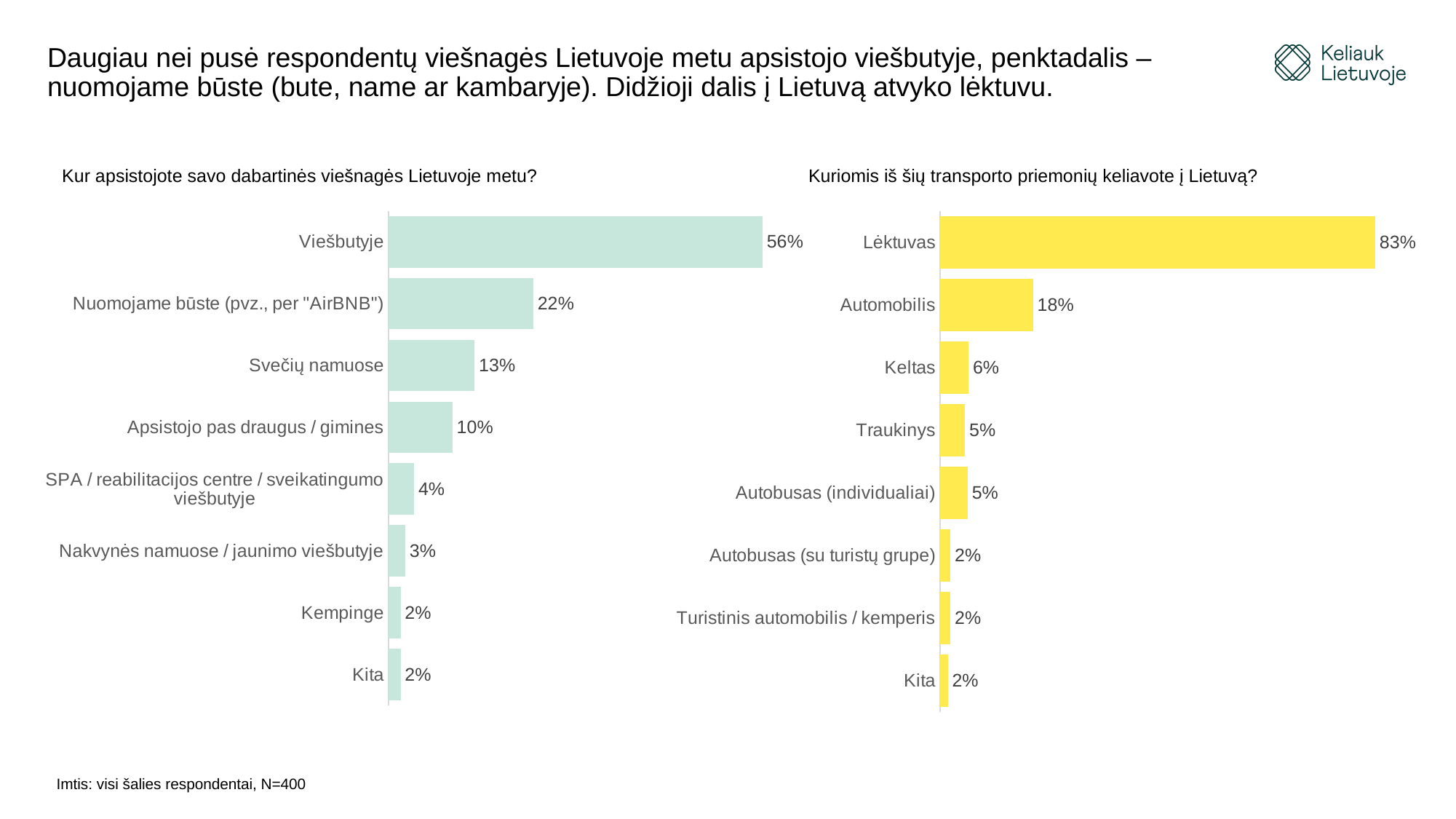
In the right chart (Kuriomis iš šių transporto priemonių keliavote į Lietuvą?), which category has the highest value? Lėktuvas How many categories does the left chart (Kur apsistojote savo dabartinės viešnagės Lietuvoje metu?) show? 8 What type of chart is the right chart (Kuriomis iš šių transporto priemonių keliavote į Lietuvą?)? Bar chart In the left chart (Kur apsistojote savo dabartinės viešnagės Lietuvoje metu?), which category has the highest value? Viešbutyje In the right chart (Kuriomis iš šių transporto priemonių keliavote į Lietuvą?), which is larger: Keltas or Traukinys? Keltas In the left chart (Kur apsistojote savo dabartinės viešnagės Lietuvoje metu?), what is the value for Svečių namuose? 13% In the left chart (Kur apsistojote savo dabartinės viešnagės Lietuvoje metu?), what is the value for Viešbutyje? 56% In the left chart (Kur apsistojote savo dabartinės viešnagės Lietuvoje metu?), which is larger: Apsistojo pas draugus / gimines or SPA / reabilitacijos centre / sveikatingumo viešbutyje? Apsistojo pas draugus / gimines In the right chart (Kuriomis iš šių transporto priemonių keliavote į Lietuvą?), what is the value for Automobilis? 18% In the right chart (Kuriomis iš šių transporto priemonių keliavote į Lietuvą?), what is the difference between Lėktuvas and Automobilis? 65% How many categories does the right chart (Kuriomis iš šių transporto priemonių keliavote į Lietuvą?) show? 8 In the left chart (Kur apsistojote savo dabartinės viešnagės Lietuvoje metu?), what is the difference between Viešbutyje and Nuomojame būste (pvz., per "AirBNB")? 34%